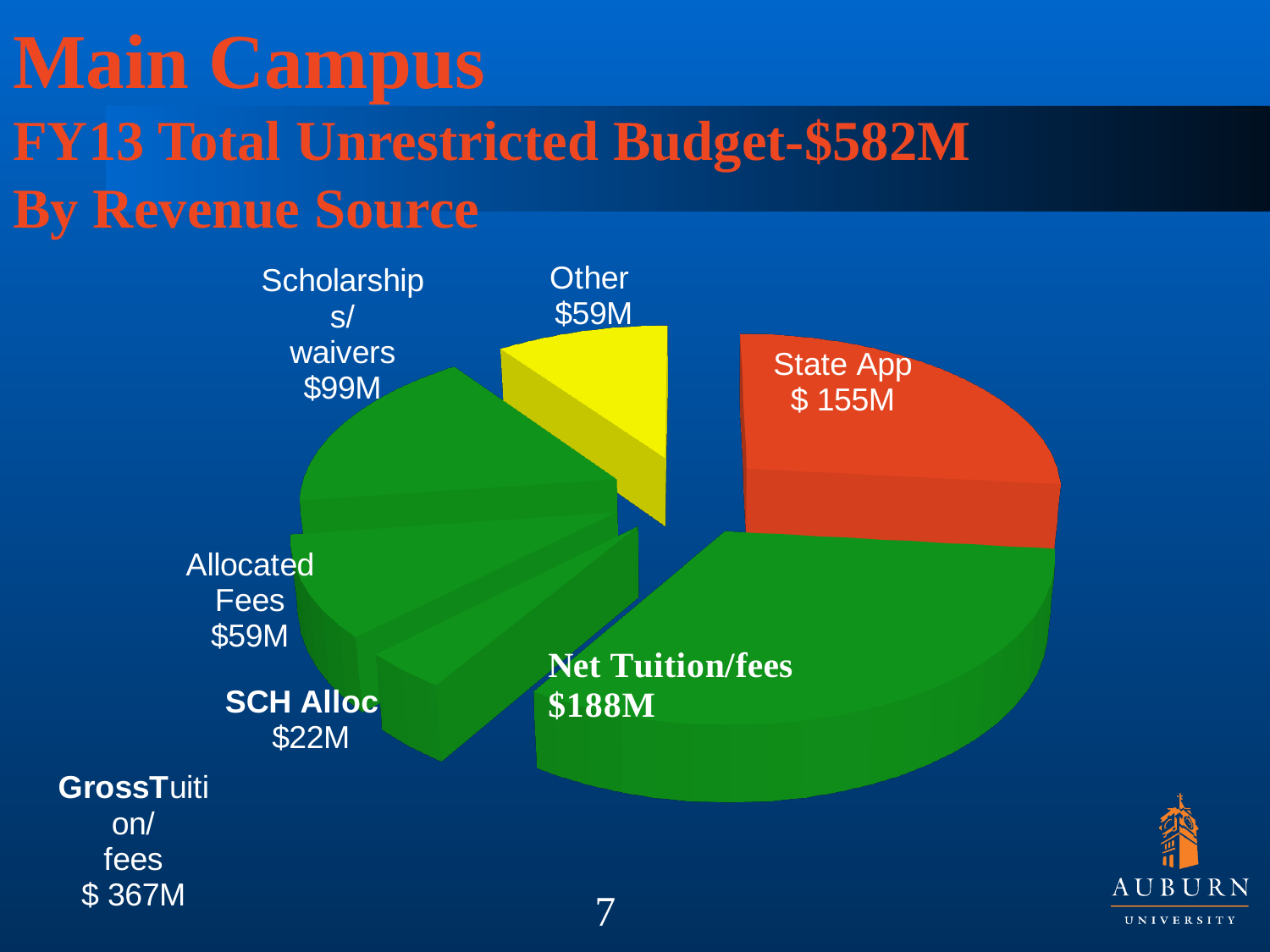
What kind of chart is shown on the slide? Pie chart What is the value shown for Net Tuition/fees? $188M How much larger is Net Tuition/fees than State App? $33M What is the value shown for Gross Tuition/fees? $ 367M Which revenue source has the smallest slice in the pie chart? SCH Alloc Which is larger, State App or Scholarships/waivers? State App What is the value shown for State App in the pie chart? $ 155M What is the value shown for Scholarships/waivers? $99M What is the difference between Scholarships/waivers and Allocated Fees? $40M What is the value shown for SCH Alloc? $22M What is the value shown for the Other slice? $59M Which revenue source has the largest slice in the pie chart? Net Tuition/fees